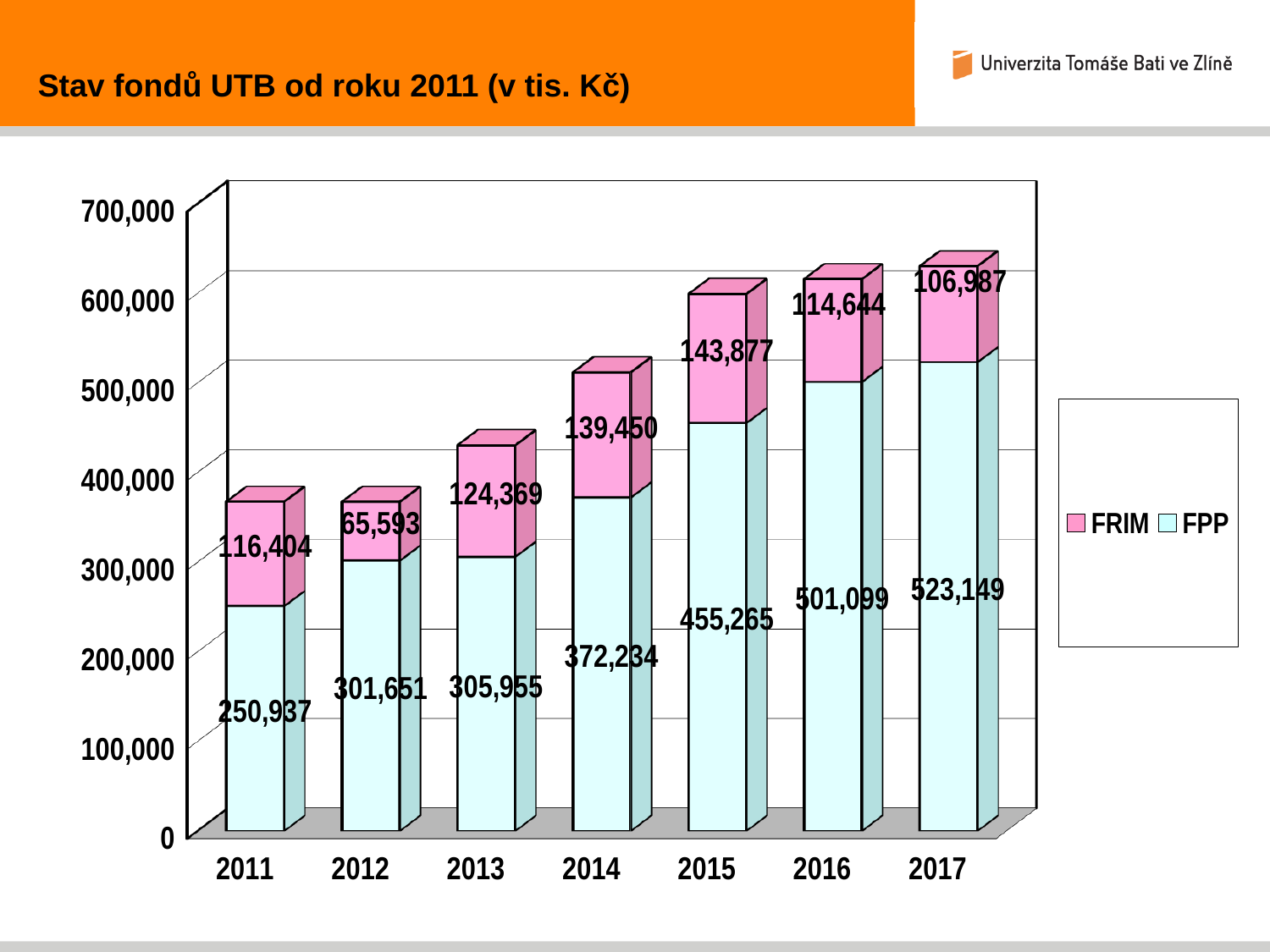
Do the FPP values rise or fall from 2011 to 2017? Rise Which year has the highest FRIM value? 2015 How many series does the legend list? 2 Which is larger, the FRIM value for 2013 or the FRIM value for 2016? 2013 What kind of chart is shown on the slide? Stacked bar chart What is the FPP value for 2014? 372,234 What is the FRIM value for 2012? 65,593 Which year has the lowest FPP value? 2011 What is the FPP value for 2017? 523,149 What is the difference between the FPP values for 2016 and 2015? 45,834 How many years are shown on the x axis? 7 What is the total of the stacked bar for 2017? 630,136